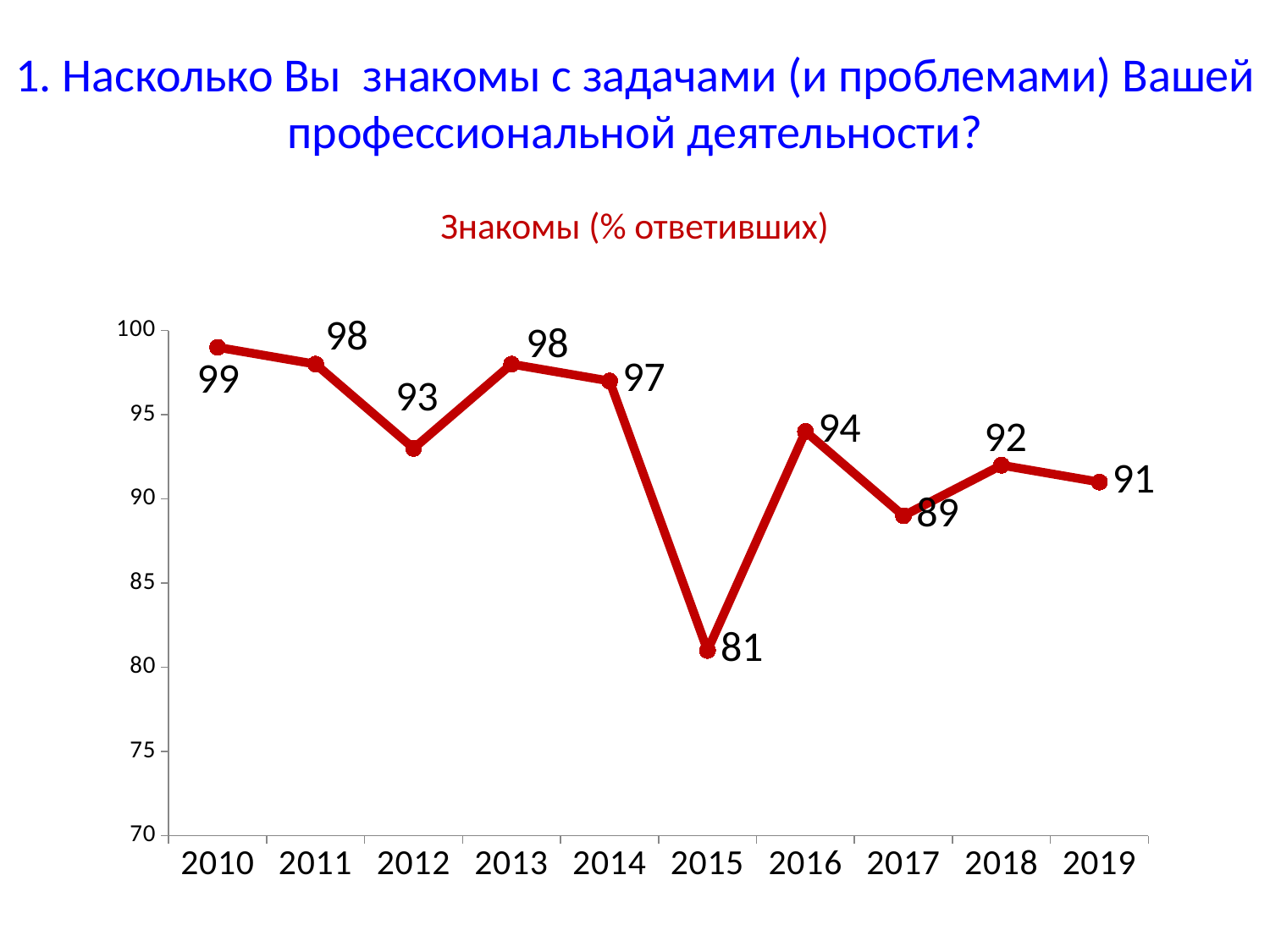
Is the value for 2015 greater or less than 85? less How many years are plotted on the chart? 10 Which year has the highest value? 2010 What is the title of the chart? Знакомы (% ответивших) What is the value for 2015? 81 Do the values rise or fall from 2017 to 2018? rise What is the value for 2019? 91 Which year has the lowest value? 2015 What is the difference between the values for 2014 and 2015? 16 What is the value for 2010? 99 What kind of chart is shown on the slide? line chart Which is larger, the value for 2016 or the value for 2017? 2016